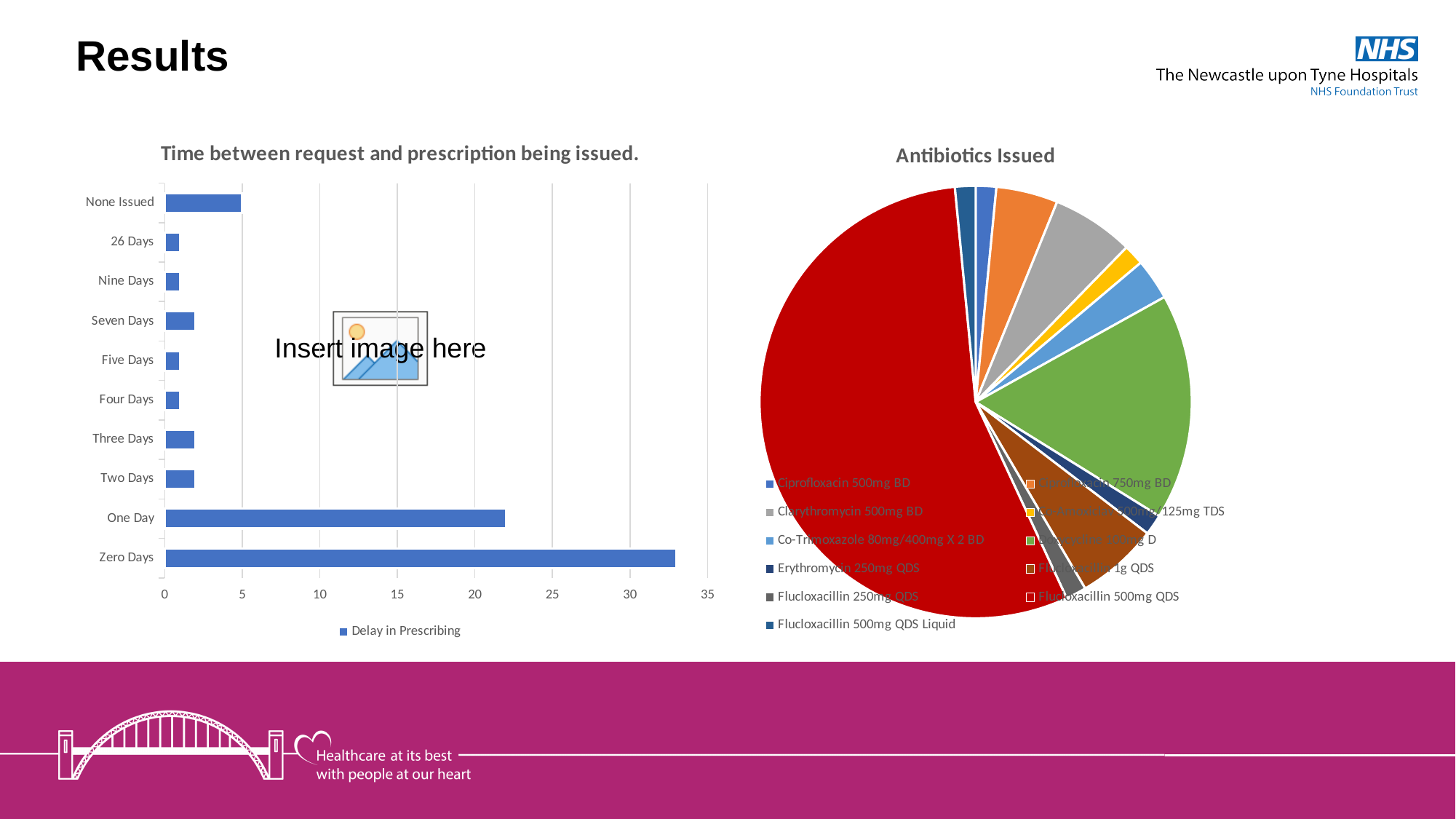
In the 'Time between request and prescription being issued.' chart, is the value for Zero Days greater or less than 30? greater In the 'Time between request and prescription being issued.' chart, which category has the highest value? Zero Days In the 'Time between request and prescription being issued.' chart, is the value for None Issued greater or less than 10? less In the 'Time between request and prescription being issued.' chart, which is larger: the value for Zero Days or the value for One Day? Zero Days In the 'Antibiotics Issued' chart, which antibiotic has the largest slice? Flucloxacillin 500mg QDS In the 'Time between request and prescription being issued.' chart, how many categories are shown on the vertical axis? 10 What kind of chart is the 'Antibiotics Issued' chart? pie chart In the 'Antibiotics Issued' chart, how many entries does the legend list? 11 What kind of chart is the 'Time between request and prescription being issued.' chart? bar chart In the 'Time between request and prescription being issued.' chart, is the value for One Day greater or less than 20? greater In the 'Time between request and prescription being issued.' chart, how many series does the legend list? 1 In the 'Time between request and prescription being issued.' chart, what is the name of the series in the legend? Delay in Prescribing